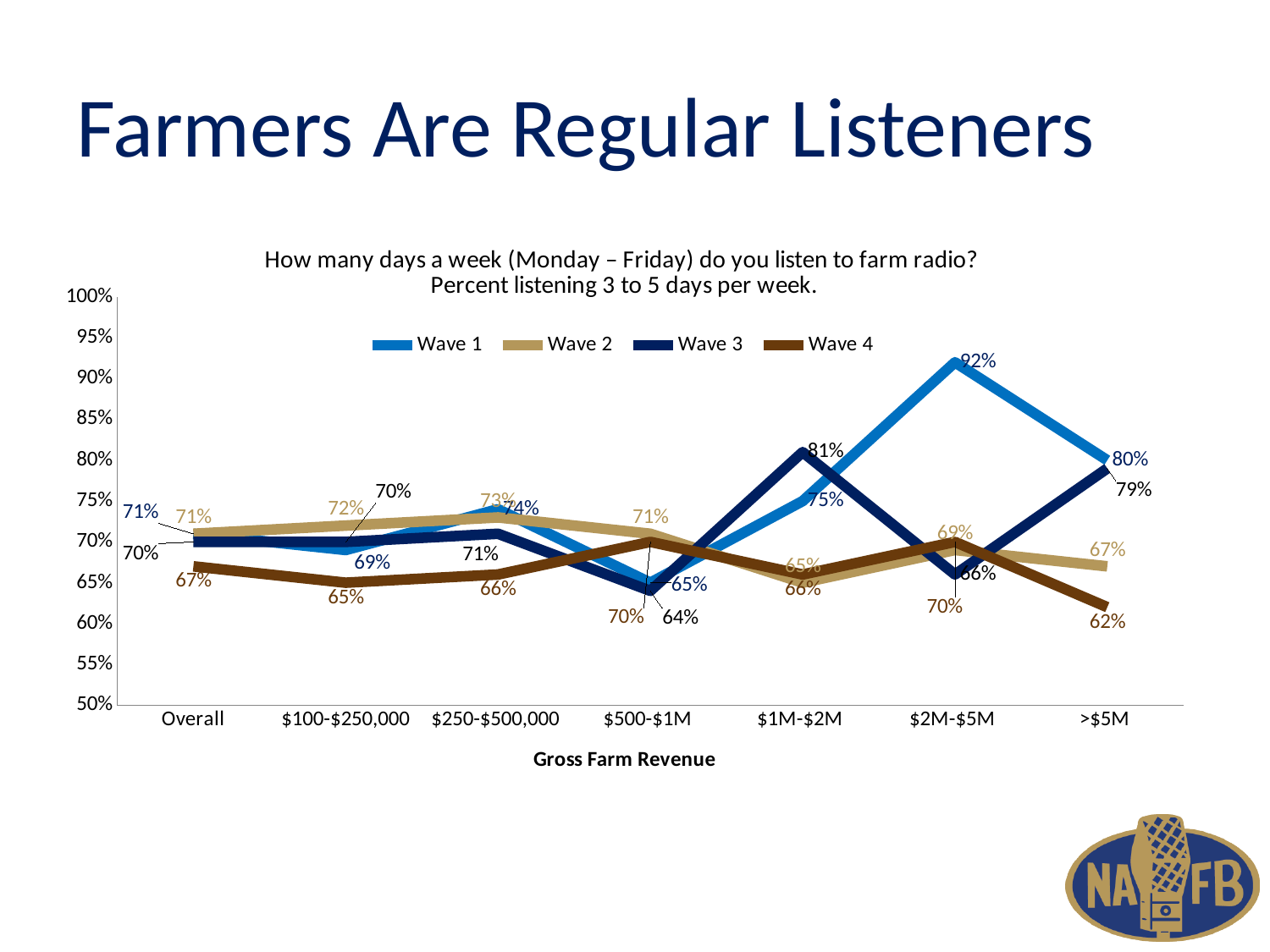
What is the Wave 4 value for the >$5M category? 62% What is the Wave 3 value for the $1M-$2M category? 81% What is the Wave 2 value for the $500-$1M category? 71% In which category does Wave 4 have its lowest value? >$5M In which category does Wave 1 reach its highest value? $2M-$5M In the $1M-$2M category, which is larger: Wave 1 or Wave 3? Wave 3 How many gross farm revenue categories are plotted along the x axis? 7 How many series does the legend list? 4 What kind of chart is shown on the slide? line chart What is the Wave 1 value for the $2M-$5M category? 92% In the $2M-$5M category, how many percentage points higher is Wave 1 than Wave 3? 26 percentage points What is the title of the x axis? Gross Farm Revenue